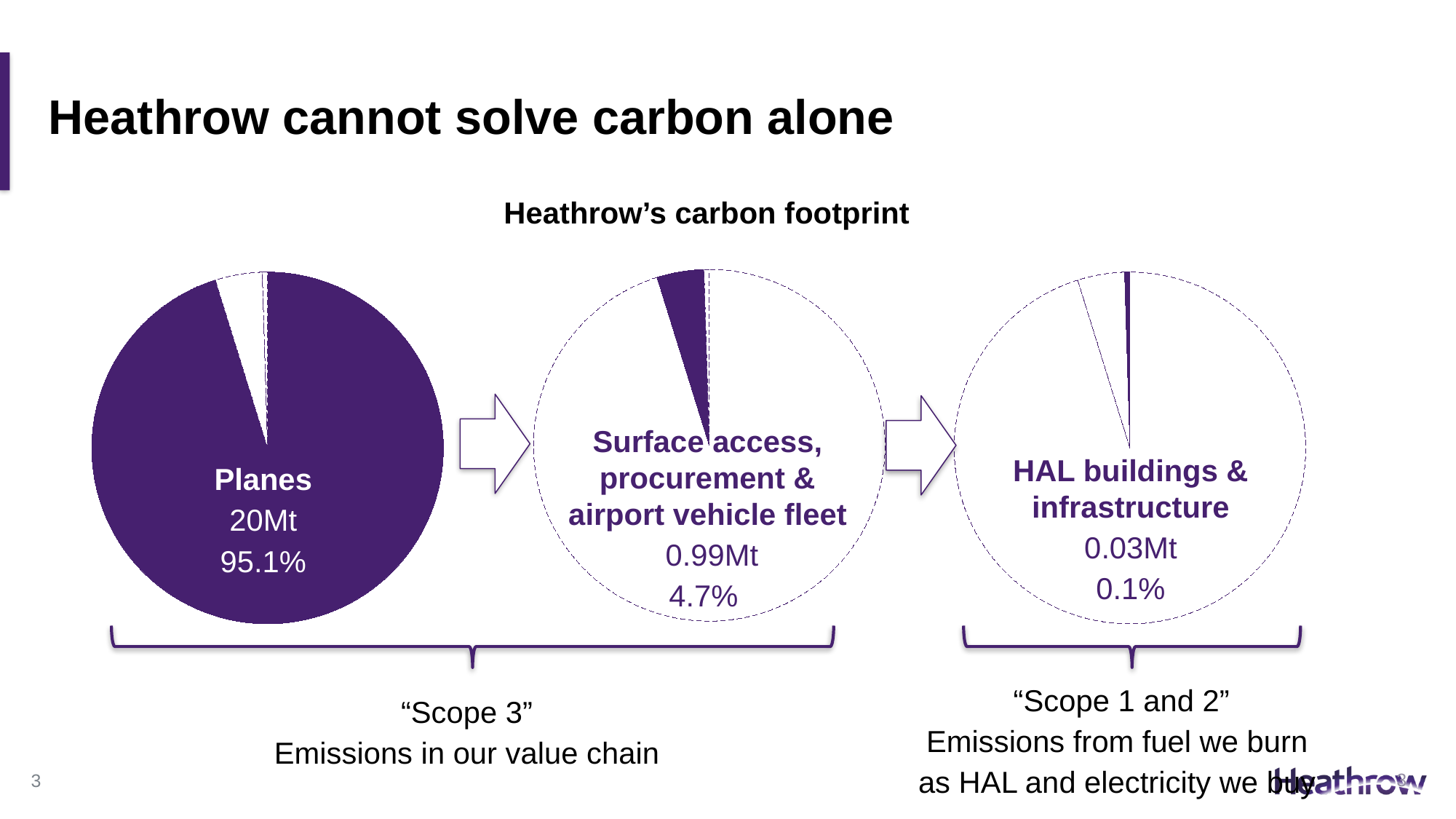
In Heathrow's carbon footprint, what is the emissions value for HAL buildings & infrastructure? 0.03Mt In Heathrow's carbon footprint, what share of emissions comes from Surface access, procurement & airport vehicle fleet? 4.7% In Heathrow's carbon footprint, what share of emissions comes from Planes? 95.1% In Heathrow's carbon footprint, what is the emissions value for Planes? 20Mt What kind of chart is used to show Heathrow's carbon footprint on this slide? Pie chart What is the title of the chart on the slide? Heathrow's carbon footprint In Heathrow's carbon footprint, what is the emissions value for Surface access, procurement & airport vehicle fleet? 0.99Mt Which category accounts for the smallest share of Heathrow's carbon footprint? HAL buildings & infrastructure In Heathrow's carbon footprint, what share of emissions comes from HAL buildings & infrastructure? 0.1% How many emission categories are shown in Heathrow's carbon footprint? 3 Which category accounts for the largest share of Heathrow's carbon footprint? Planes Which is larger in Heathrow's carbon footprint: Surface access, procurement & airport vehicle fleet or HAL buildings & infrastructure? Surface access, procurement & airport vehicle fleet